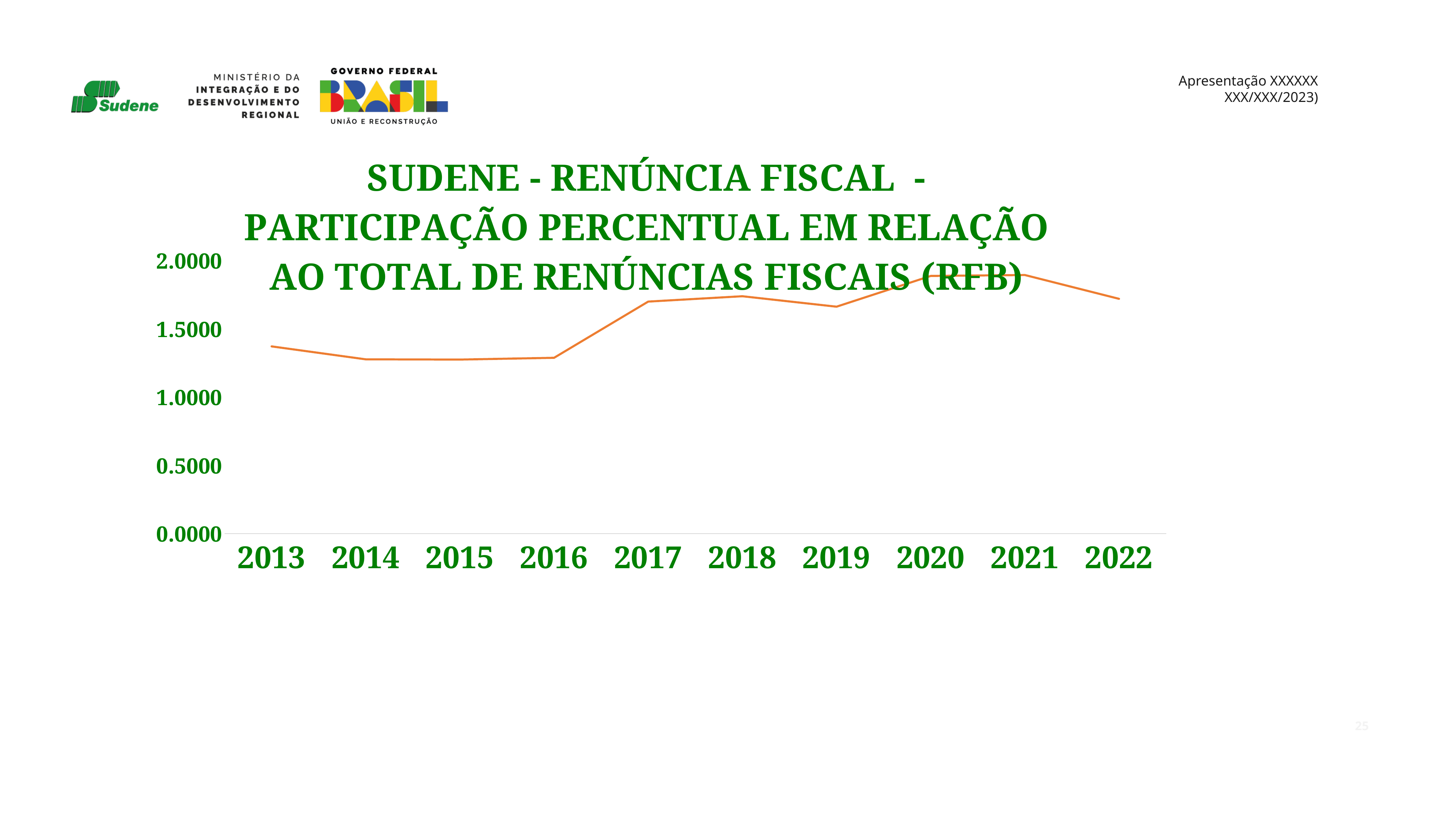
Is the value for 2013 greater or less than 1.0000? greater What kind of chart is shown on the slide? line chart Which year has the larger value, 2013 or 2020? 2020 Does the line rise or fall between 2016 and 2017? rises Does the line rise or fall between 2021 and 2022? falls How many years are plotted along the x axis of the chart? 10 Which year has the larger value, 2016 or 2017? 2017 Is the value for 2017 greater or less than 1.5000? greater Is the value for 2021 greater or less than 2.0000? less What is the first year shown on the x axis of the chart? 2013 What colour is the line plotted in the chart? orange